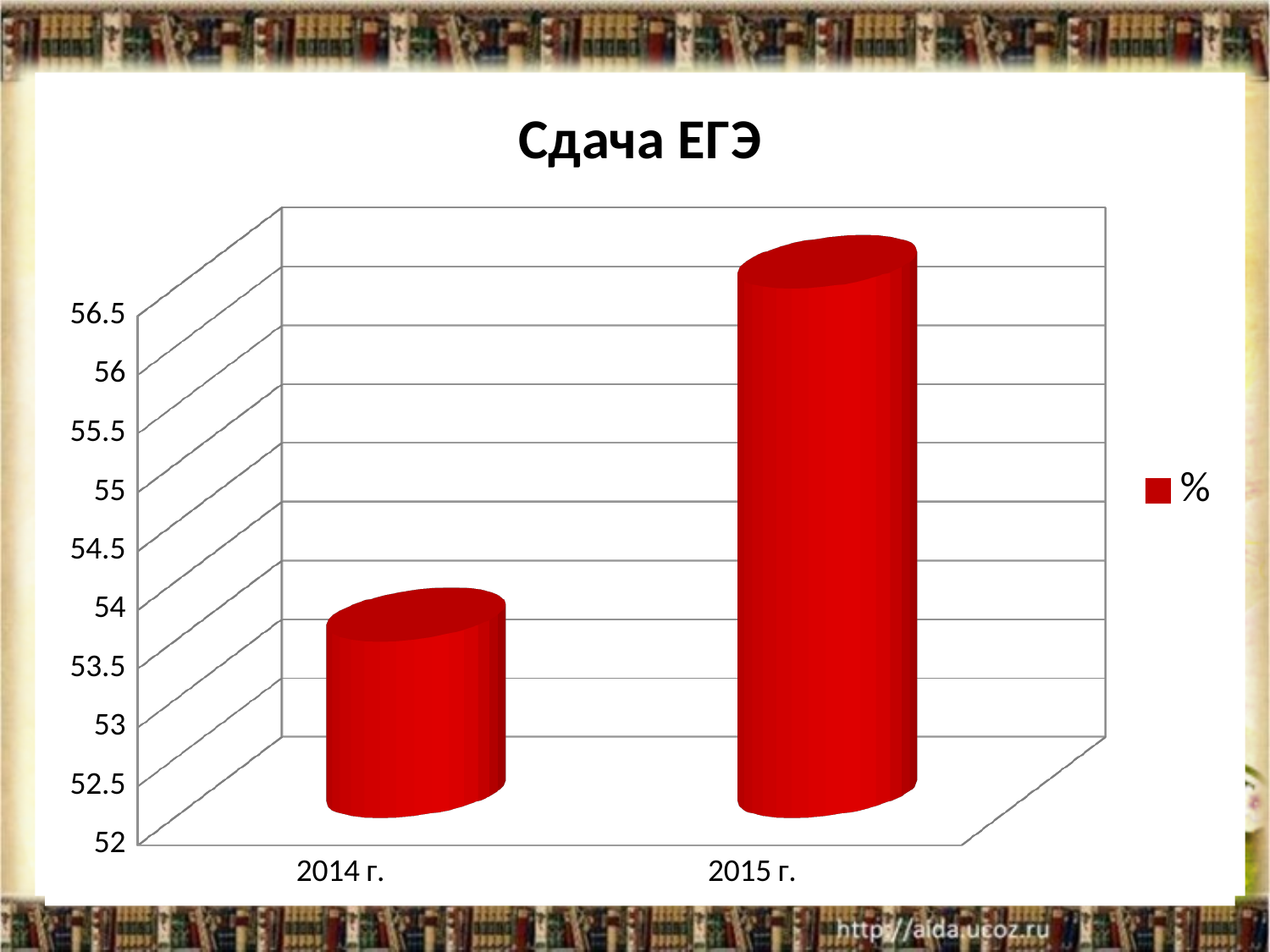
Is the value for 2014 г. greater or less than 52.5? greater How many categories are shown on the x axis of the chart? 2 Do the values rise or fall from 2014 г. to 2015 г.? rise Which year has the highest value in the chart? 2015 г. Which year has the lowest value in the chart? 2014 г. Which is larger, the value for 2014 г. or the value for 2015 г.? 2015 г. Is the value for 2015 г. greater or less than 56? greater Is the value for 2014 г. greater or less than 55? less How many series does the legend list? 1 What kind of chart is shown on the slide? bar chart What is the title of the chart? Сдача ЕГЭ What is the legend entry for the series in the chart? %